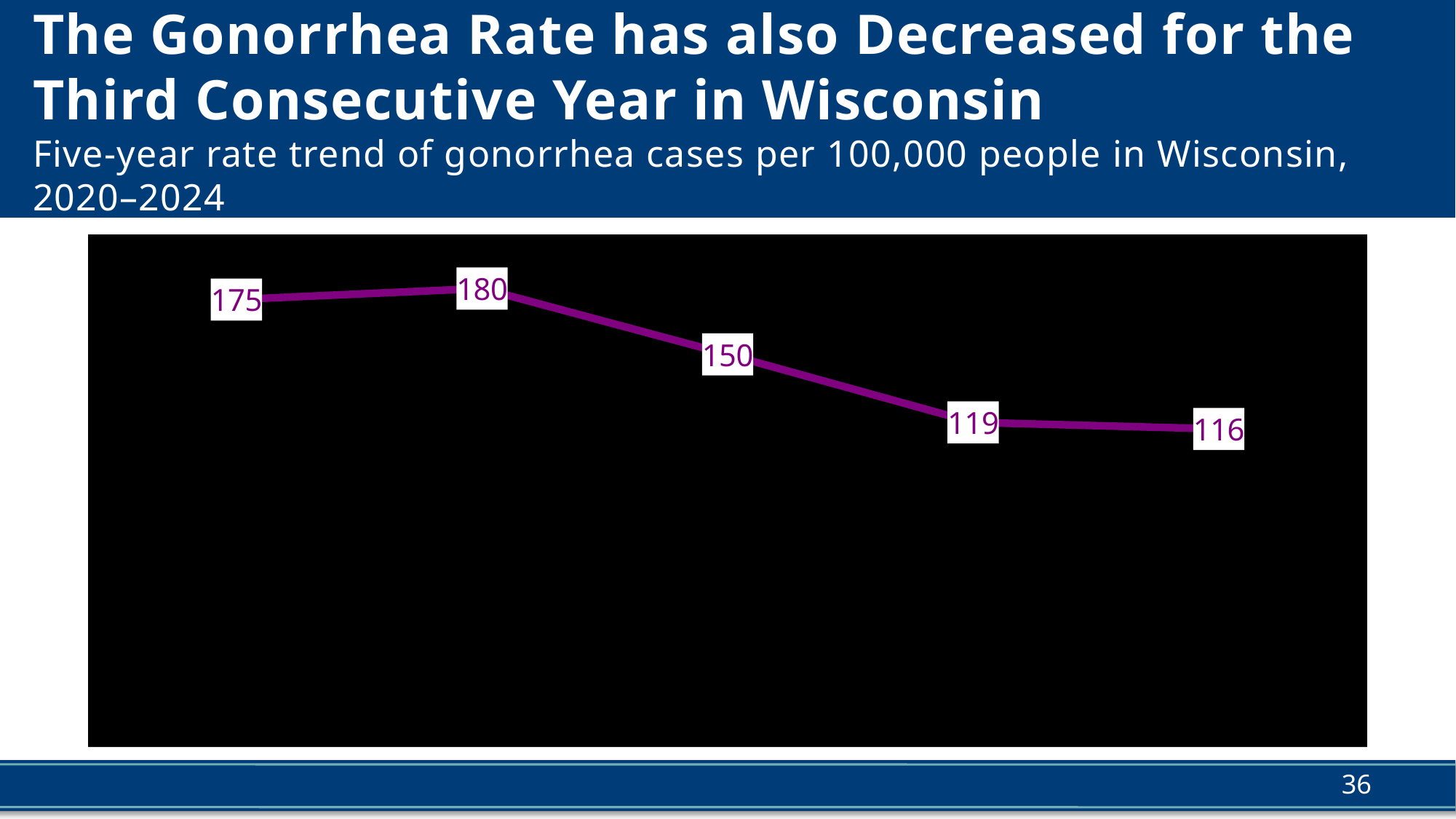
Which is larger, the second data point or the fourth data point? the second data point (180) What is the difference between the highest value (180) and the lowest value (116) on the line? 64 What is the value of the first (leftmost) data point on the line? 175 What colour is the line in the chart? purple What is the lowest value plotted on the line? 116 What is the value of the middle (third) data point on the line? 150 What is the highest value plotted on the line? 180 Do the values generally rise or fall from left to right after the second data point? fall How many data points are plotted on the line? 5 What is the value of the last (rightmost) data point on the line? 116 What kind of chart is shown on the slide? line chart What is the difference between the first data point (175) and the last data point (116)? 59